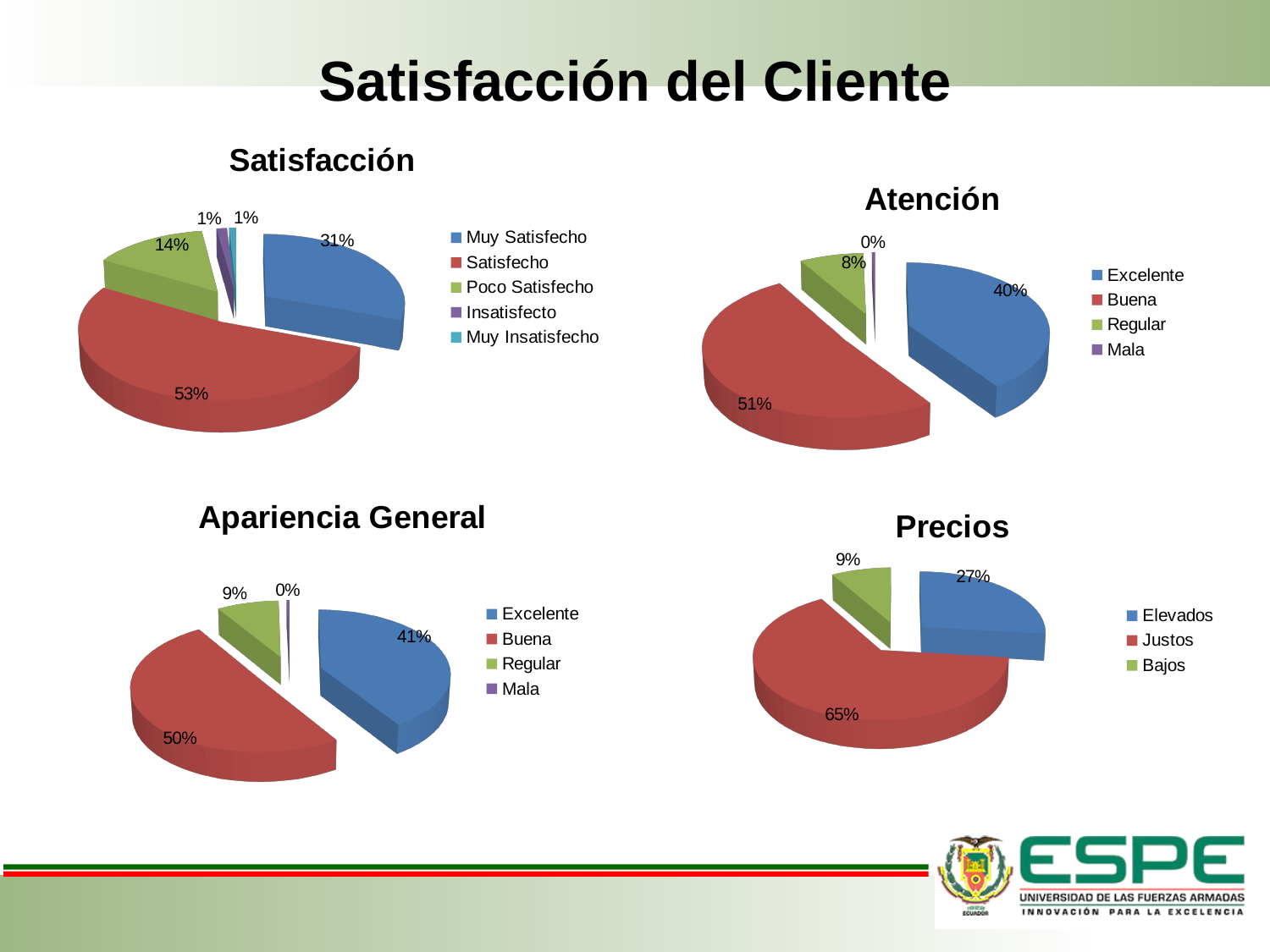
In the 'Atención' chart, what is the difference between the Buena and Regular shares? 43% In the 'Satisfacción' chart, which category has the largest share? Satisfecho In the 'Atención' chart, which category has the smallest share? Mala What type of chart is the 'Precios' chart? Pie chart In the 'Satisfacción' chart, what percentage is shown for Satisfecho? 53% In the 'Precios' chart, what percentage is shown for Justos? 65% In the 'Satisfacción' chart, what percentage is shown for Muy Satisfecho? 31% In the 'Precios' chart, how many categories does the legend list? 3 In the 'Satisfacción' chart, how many categories does the legend list? 5 In the 'Atención' chart, what percentage is shown for Excelente? 40% In the 'Apariencia General' chart, what percentage is shown for Buena? 50% In the 'Apariencia General' chart, which is larger, Excelente or Regular? Excelente